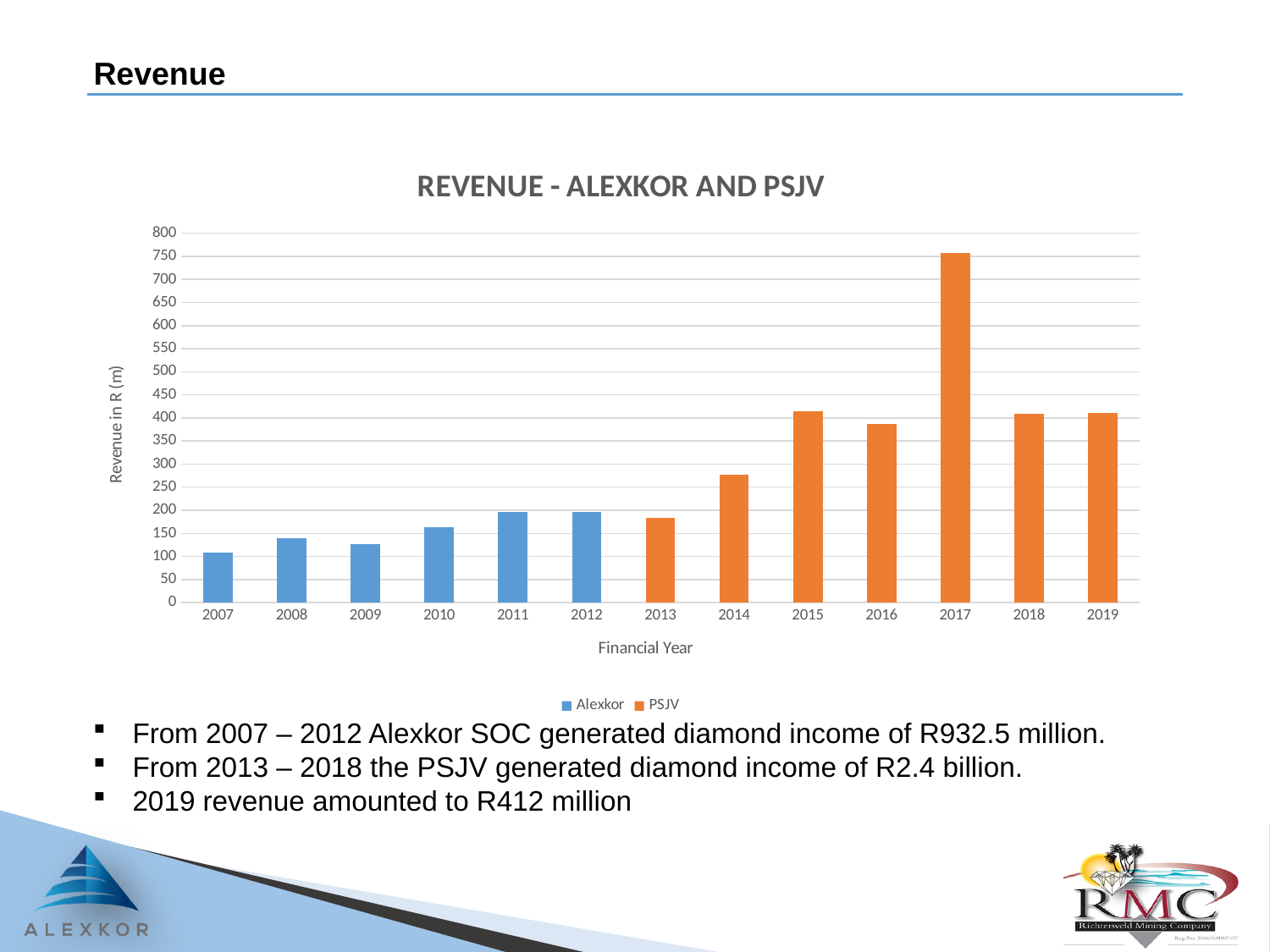
How many series does the legend list? 2 Is the revenue for 2009 greater or less than 150? less Is the revenue for 2014 greater or less than 250? greater What kind of chart is shown on the slide? bar chart How many financial years are shown on the x axis? 13 Which year has higher revenue, 2013 or 2014? 2014 Is the revenue for 2017 greater or less than 700? greater What is the label of the y axis? Revenue in R (m) What is the title of the chart? REVENUE - ALEXKOR AND PSJV Which financial year has the lowest revenue? 2007 Which financial year has the highest revenue? 2017